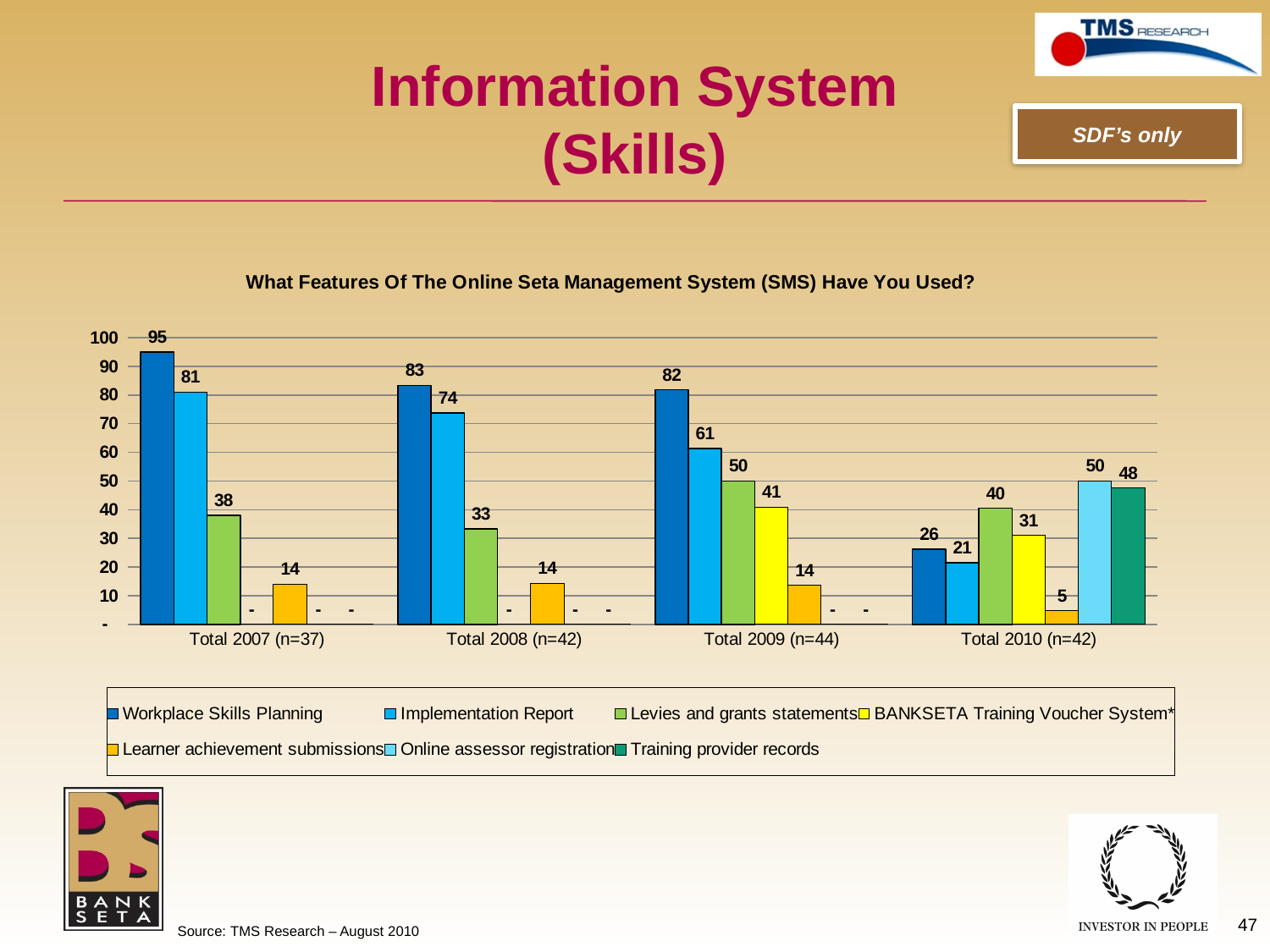
Which is larger: Levies and grants statements in Total 2009 (n=44) or in Total 2008 (n=42)? Total 2009 (n=44) What is the value for Implementation Report in Total 2009 (n=44)? 61 What is the value for Learner achievement submissions in Total 2010 (n=42)? 5 What is the value for Online assessor registration in Total 2010 (n=42)? 50 How many series does the legend list? 7 In which year group is the Workplace Skills Planning value highest? Total 2007 (n=37) How many year groups are shown on the x axis? 4 What is the value for Workplace Skills Planning in Total 2007 (n=37)? 95 What is the difference between the Workplace Skills Planning values for Total 2007 (n=37) and Total 2010 (n=42)? 69 What kind of chart is shown on the slide? Bar chart Does the Workplace Skills Planning value rise or fall from Total 2007 to Total 2010? Fall In which year group is the Workplace Skills Planning value lowest? Total 2010 (n=42)